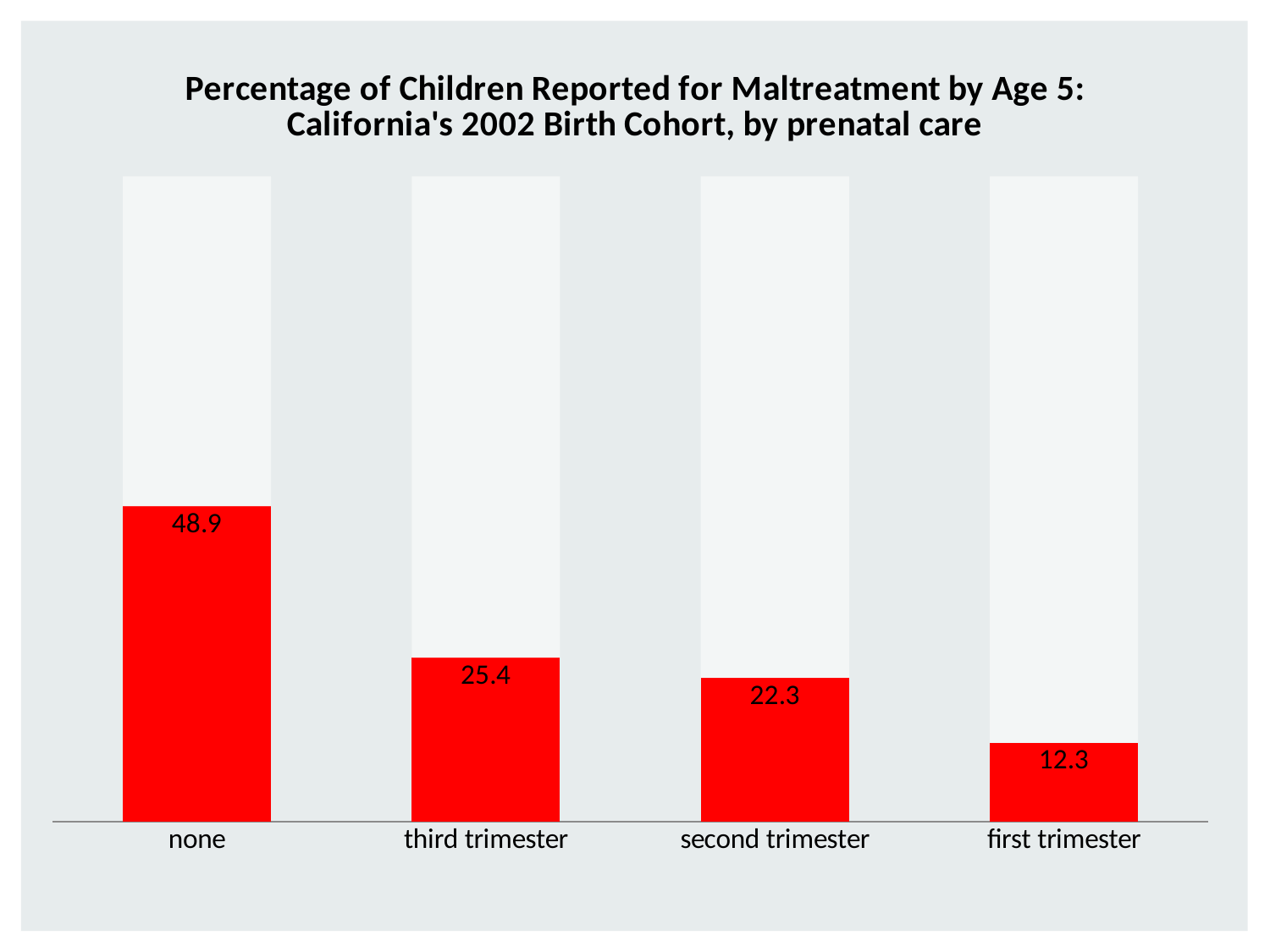
Which prenatal care category has the lowest percentage of children reported for maltreatment? first trimester What is the difference between the values for 'third trimester' and 'second trimester'? 3.1 What is the value for the 'first trimester' category? 12.3 What is the value for the 'third trimester' category? 25.4 How many prenatal care categories are shown on the chart? 4 Which prenatal care category has the highest percentage of children reported for maltreatment? none What kind of chart is shown on the slide? bar chart Which is larger, the value for 'third trimester' or the value for 'second trimester'? third trimester What is the value for the 'none' prenatal care category? 48.9 What is the difference between the values for 'none' and 'first trimester'? 36.6 Do the values rise or fall moving from left to right along the x axis? fall What is the value for the 'second trimester' category? 22.3